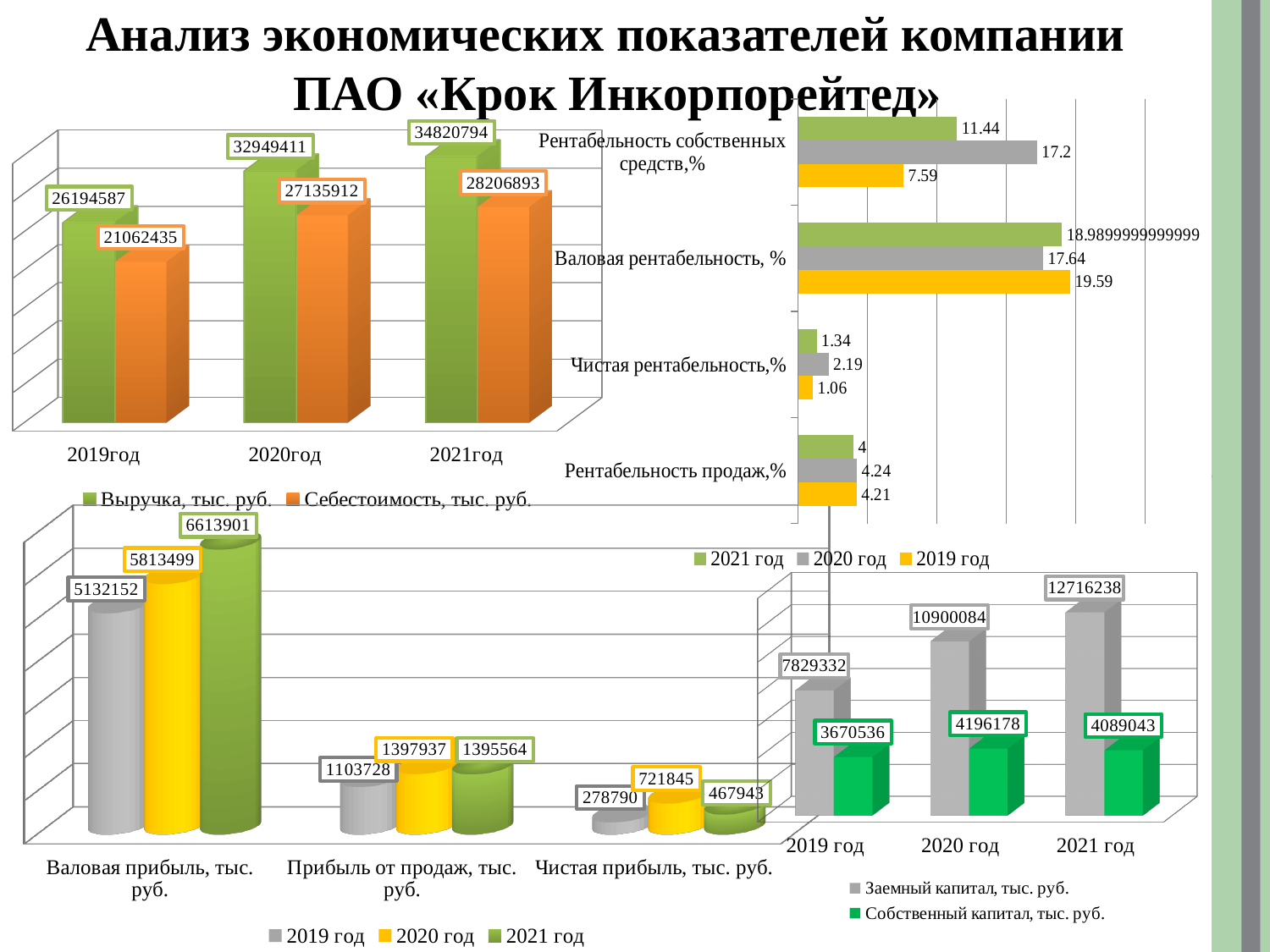
On the top-right chart, which year has the lowest Чистая рентабельность,%? 2019 год On the top-left chart, what is the difference between Выручка and Себестоимость for 2020год? 5813499 On the top-left chart, does Выручка rise or fall from 2019год to 2021год? rise On the top-right chart, is the value of Валовая рентабельность, % for 2019 год greater or less than 15? greater On the bottom-right chart, what is the value of Заемный капитал, тыс. руб. for 2021 год? 12716238 On the top-left chart, what is the value of Себестоимость, тыс. руб. for 2019год? 21062435 On the bottom-right chart, which is larger for 2019 год: Заемный капитал or Собственный капитал? Заемный капитал, тыс. руб. On the bottom-left chart, which year has the highest Валовая прибыль, тыс. руб.? 2021 год On the top-right chart, what is the value of Рентабельность собственных средств,% for 2020 год? 17.2 On the top-right chart, how many series does the legend list? 3 On the top-left chart, what is the value of Выручка, тыс. руб. for 2021год? 34820794 On the bottom-left chart, what is the value of Чистая прибыль, тыс. руб. for 2020 год? 721845